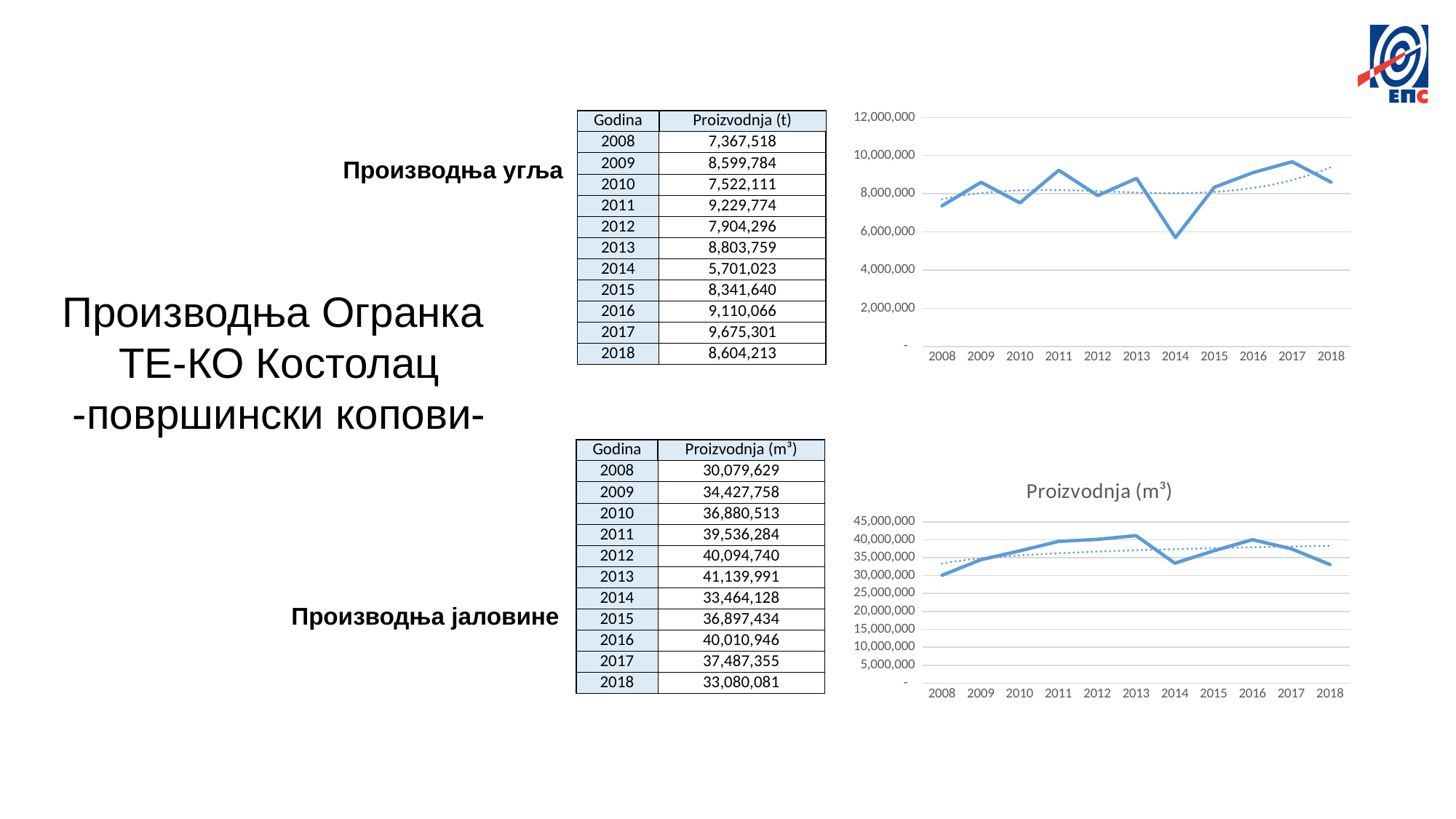
In the top chart, is the value for 2014 greater or less than 6,000,000? less In the bottom chart titled 'Proizvodnja (m³)', which year has the lowest value? 2008 What kind of chart is the top chart? line chart What is the title of the bottom chart? Proizvodnja (m³) In the top chart (coal production in tonnes), which year has the highest value? 2017 In the top chart (coal production in tonnes), which year has the lowest value? 2014 In the bottom chart titled 'Proizvodnja (m³)', which is larger, the value for 2016 or the value for 2017? 2016 In the top chart, does the value rise or fall from 2013 to 2014? fall According to the top table and chart, what was the coal production (t) in 2014? 5,701,023 Using the top table, what is the difference between the 2017 and 2018 coal production values? 1,071,088 How many years are plotted along the x axis of the top chart? 11 In the bottom chart titled 'Proizvodnja (m³)', which year has the highest value? 2013